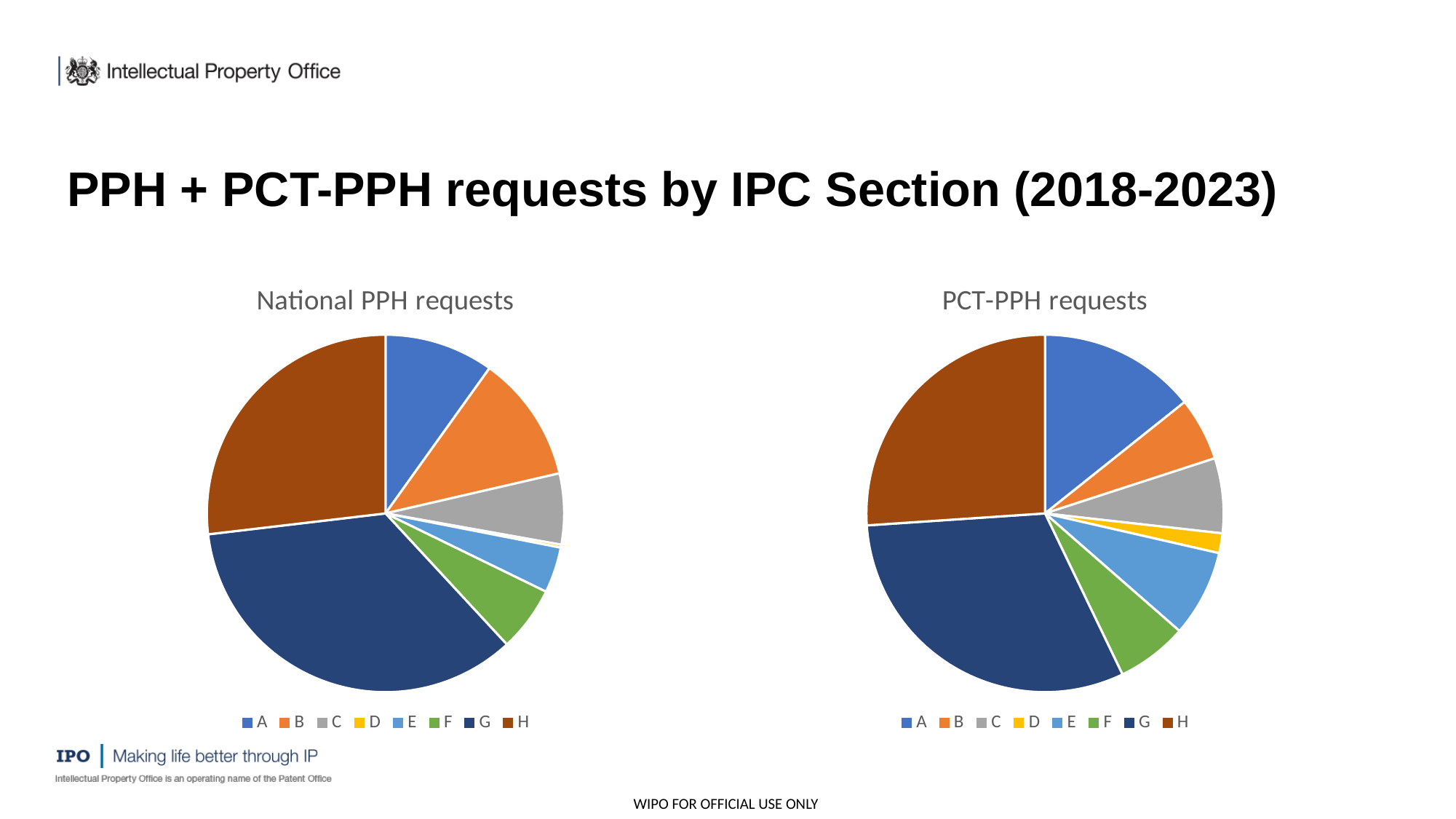
In the "PCT-PPH requests" chart, which slice is larger, A or B? A How many entries does the legend of the "National PPH requests" chart list? 8 In the "National PPH requests" chart, which slice is larger, H or A? H What kind of chart is the "PCT-PPH requests" chart? pie chart How many IPC sections are listed in the legend of the "PCT-PPH requests" chart? 8 In the "National PPH requests" chart, which IPC section has the smallest slice? D In the "PCT-PPH requests" chart, which IPC section has the smallest slice? D In the "PCT-PPH requests" chart, which IPC section has the largest slice? G In the "National PPH requests" chart, which slice is larger, B or C? B What kind of chart is the "National PPH requests" chart? pie chart What colour represents section H in both pie charts? brown In the "National PPH requests" chart, which IPC section has the largest slice? G